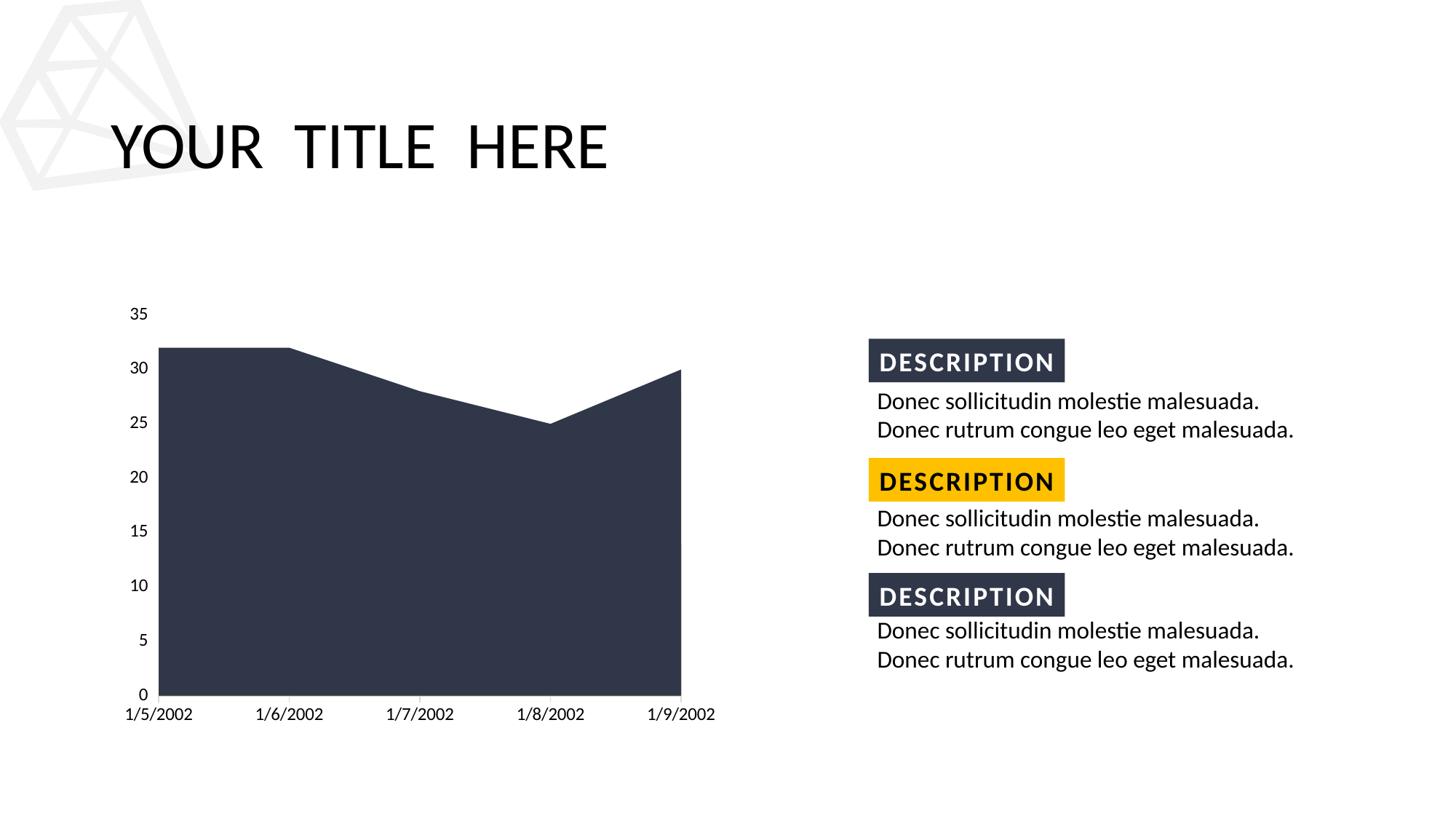
Is the value for 1/7/2002 greater or less than 25? greater How many dates are shown along the x axis of the chart? 5 Do the values rise or fall from 1/8/2002 to 1/9/2002? rise Is the value for 1/5/2002 greater or less than 30? greater Which has the larger value, 1/9/2002 or 1/8/2002? 1/9/2002 Is the value for 1/9/2002 greater or less than 25? greater Do the values rise or fall from 1/6/2002 to 1/8/2002? fall What is the highest value shown on the chart's y axis? 35 Which date has the lowest value in the chart? 1/8/2002 Which has the larger value, 1/6/2002 or 1/8/2002? 1/6/2002 What kind of chart is shown on the slide? Area chart